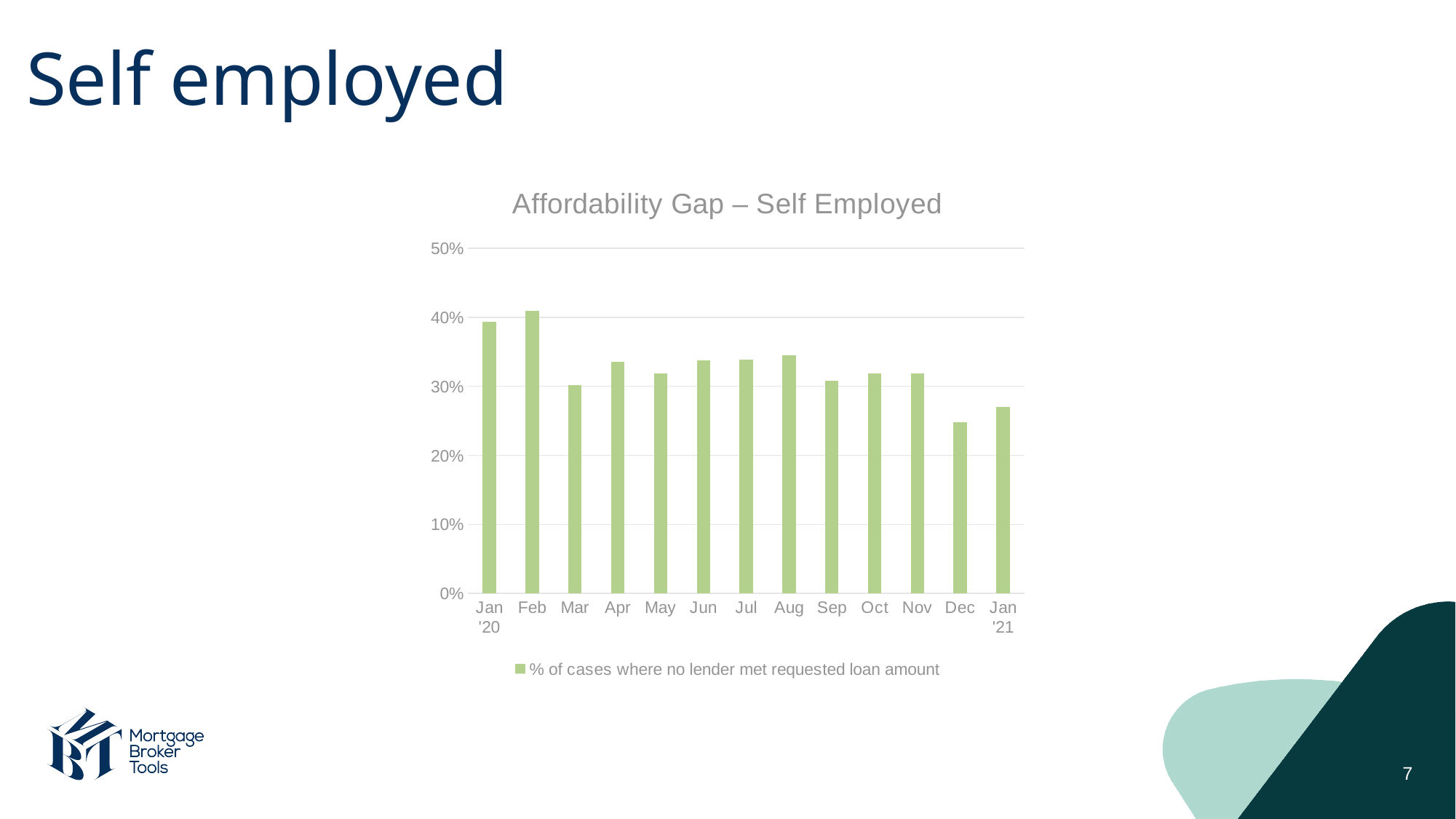
Is the value for Jan '20 greater or less than 40%? less Which month has the highest value? Feb Which month has the lowest value? Dec Is the value for Aug greater or less than 30%? greater Is the value for Dec greater or less than 30%? less Which is larger, the value for Jan '20 or the value for Mar? Jan '20 Overall, do the values rise or fall from Jan '20 to Jan '21? Fall What is the title of the chart? Affordability Gap – Self Employed How many months (bars) are plotted on the chart? 13 What kind of chart is shown on the slide? Bar chart How many series does the legend list? 1